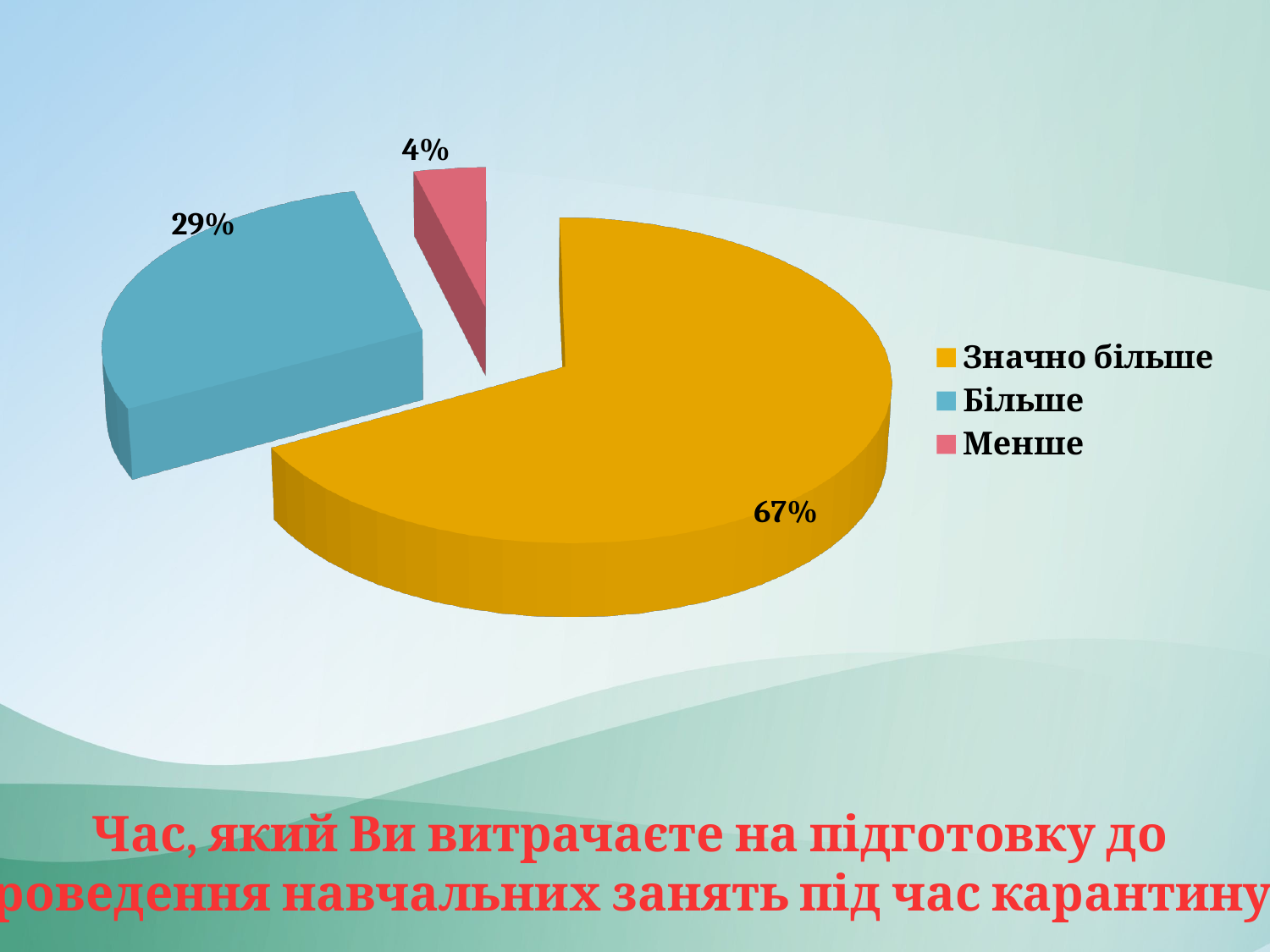
Which category has the smallest share of the pie? Менше What colour is the slice for "Менше"? Red (pink) Which legend entry is shown in blue? Більше What percentage of the pie is labelled "Більше"? 29% What is the difference in percentage points between "Більше" and "Менше"? 25 What percentage of the pie is labelled "Значно більше"? 67% What percentage of the pie is labelled "Менше"? 4% How many slices does the pie chart have? 3 What is the difference in percentage points between "Значно більше" and "Більше"? 38 Which is larger: the share for "Більше" or the share for "Менше"? Більше What type of chart is shown on the slide? Pie chart Which category has the largest share of the pie? Значно більше